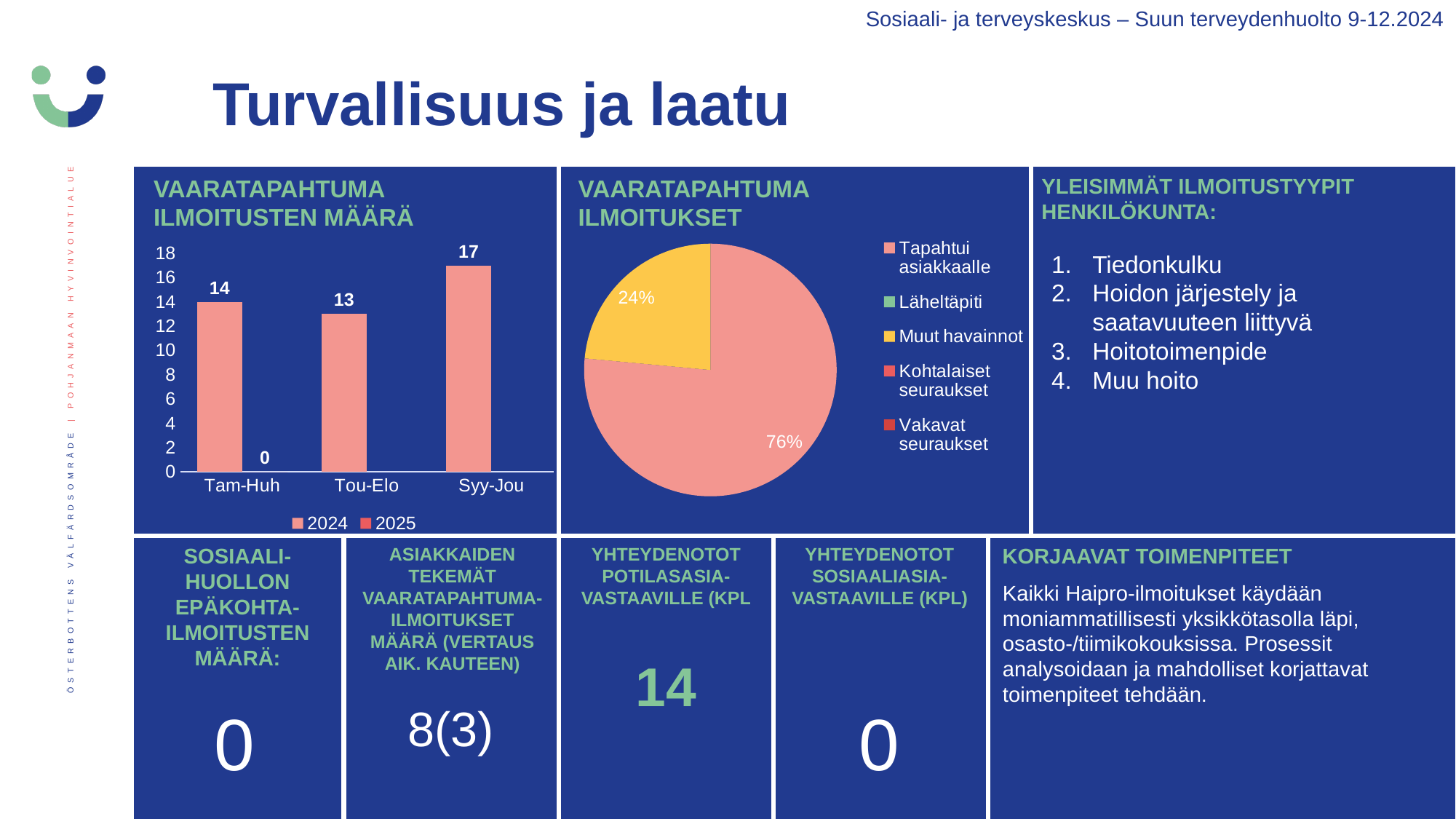
In the bar chart 'VAARATAPAHTUMA ILMOITUSTEN MÄÄRÄ', what is the 2025 value for Tam-Huh? 0 What kind of chart is 'VAARATAPAHTUMA ILMOITUKSET'? pie chart In the bar chart 'VAARATAPAHTUMA ILMOITUSTEN MÄÄRÄ', how many periods are shown on the x axis? 3 In the pie chart 'VAARATAPAHTUMA ILMOITUKSET', what share does 'Muut havainnot' have? 24% In the pie chart 'VAARATAPAHTUMA ILMOITUKSET', what share does 'Tapahtui asiakkaalle' have? 76% In the bar chart 'VAARATAPAHTUMA ILMOITUSTEN MÄÄRÄ', what is the 2024 value for Syy-Jou? 17 In the bar chart 'VAARATAPAHTUMA ILMOITUSTEN MÄÄRÄ', what is the difference between the 2024 values for Syy-Jou and Tou-Elo? 4 In the bar chart 'VAARATAPAHTUMA ILMOITUSTEN MÄÄRÄ', which period has the lowest 2024 value? Tou-Elo In the bar chart 'VAARATAPAHTUMA ILMOITUSTEN MÄÄRÄ', how many series does the legend list? 2 In the bar chart 'VAARATAPAHTUMA ILMOITUSTEN MÄÄRÄ', which period has the highest 2024 value? Syy-Jou In the bar chart 'VAARATAPAHTUMA ILMOITUSTEN MÄÄRÄ', do the 2024 values rise or fall from Tou-Elo to Syy-Jou? rise In the bar chart 'VAARATAPAHTUMA ILMOITUSTEN MÄÄRÄ', what is the 2024 value for Tam-Huh? 14